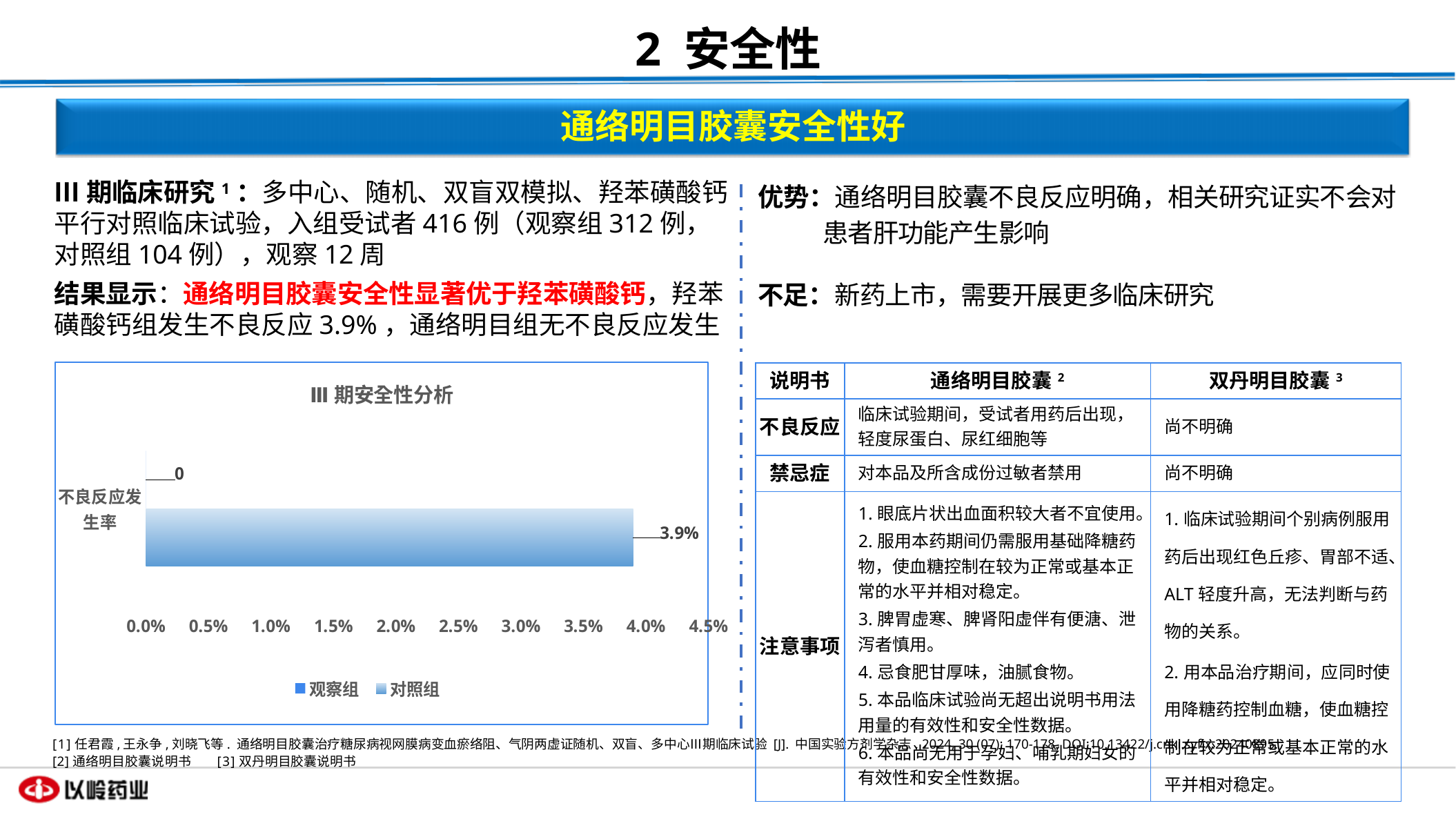
What are the two series listed in the chart legend? 观察组 and 对照组 What kind of chart is shown on the slide? bar chart Which series has the higher 不良反应发生率 in the chart? 对照组 What is the title of the chart on the slide? III 期安全性分析 Is the value for 对照组 greater or less than 3.5%? greater How many series does the chart legend list? 2 Is the value for 对照组 greater or less than 4.0%? less How many categories are shown on the vertical axis of the chart? 1 Which series has the lowest value in the chart? 观察组 What is the value for 对照组 in the chart? 3.9% Which series has the highest value in the chart? 对照组 What is the value for 观察组 in the chart? 0